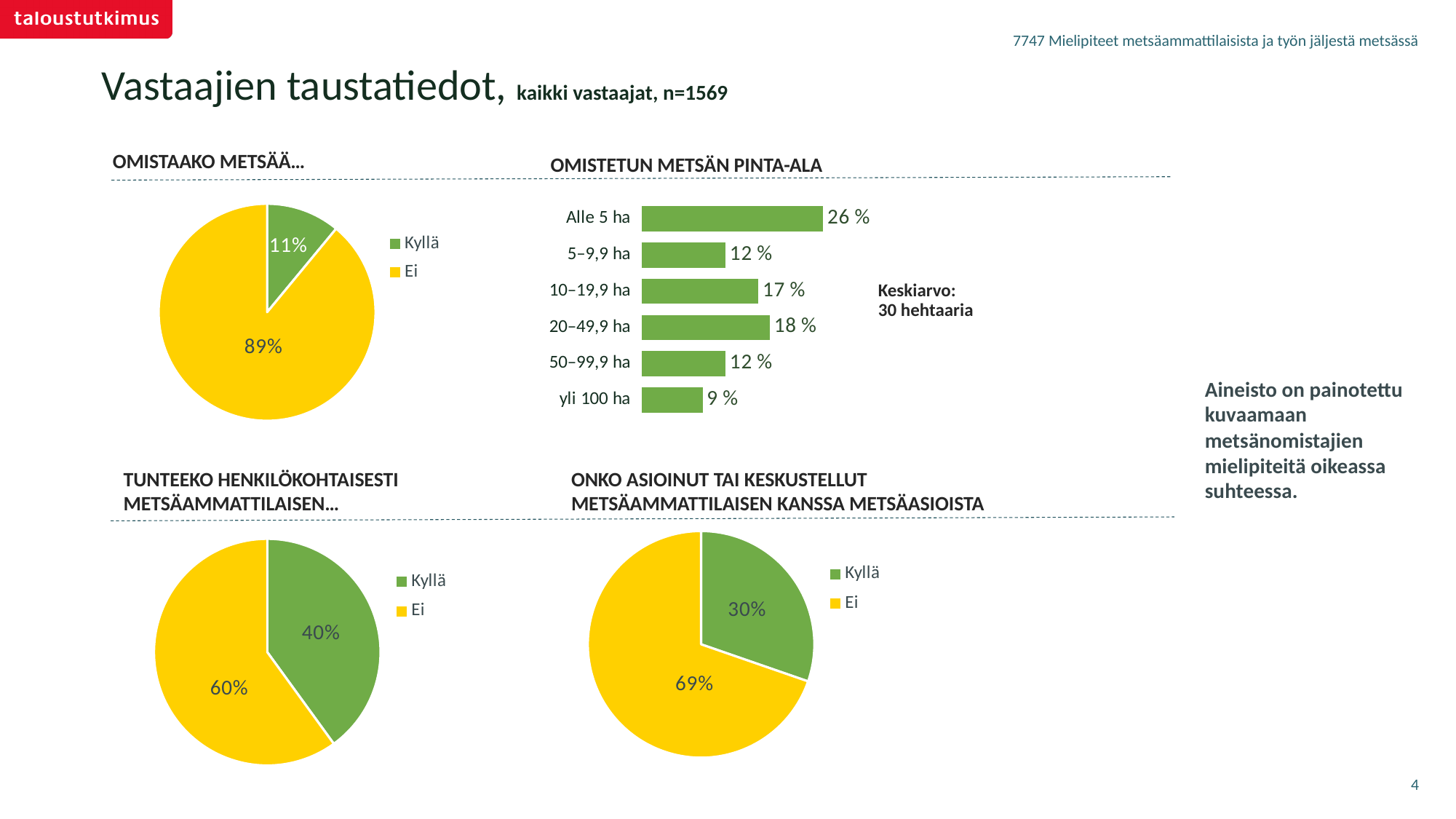
In the 'OMISTETUN METSÄN PINTA-ALA' bar chart, what is the value for Alle 5 ha? 26 % In the 'ONKO ASIOINUT TAI KESKUSTELLUT METSÄAMMATTILAISEN KANSSA METSÄASIOISTA' pie chart, which is larger, Kyllä or Ei? Ei In the 'OMISTETUN METSÄN PINTA-ALA' bar chart, what is the difference between the values for 20–49,9 ha and 10–19,9 ha? 1 % How many entries does the legend of the 'TUNTEEKO HENKILÖKOHTAISESTI METSÄAMMATTILAISEN...' pie chart list? 2 In the 'OMISTAAKO METSÄÄ...' pie chart, what share is labelled for Kyllä? 11% In the 'ONKO ASIOINUT TAI KESKUSTELLUT METSÄAMMATTILAISEN KANSSA METSÄASIOISTA' pie chart, what share is labelled for Ei? 69% In the 'OMISTETUN METSÄN PINTA-ALA' bar chart, which category has the lowest value? yli 100 ha In the 'OMISTETUN METSÄN PINTA-ALA' bar chart, how many categories are shown? 6 In the 'OMISTETUN METSÄN PINTA-ALA' bar chart, which category has the highest value? Alle 5 ha In the 'TUNTEEKO HENKILÖKOHTAISESTI METSÄAMMATTILAISEN...' pie chart, what share is labelled for Kyllä? 40% What kind of chart is 'OMISTETUN METSÄN PINTA-ALA'? bar chart In the 'OMISTAAKO METSÄÄ...' pie chart, what share is labelled for Ei? 89%